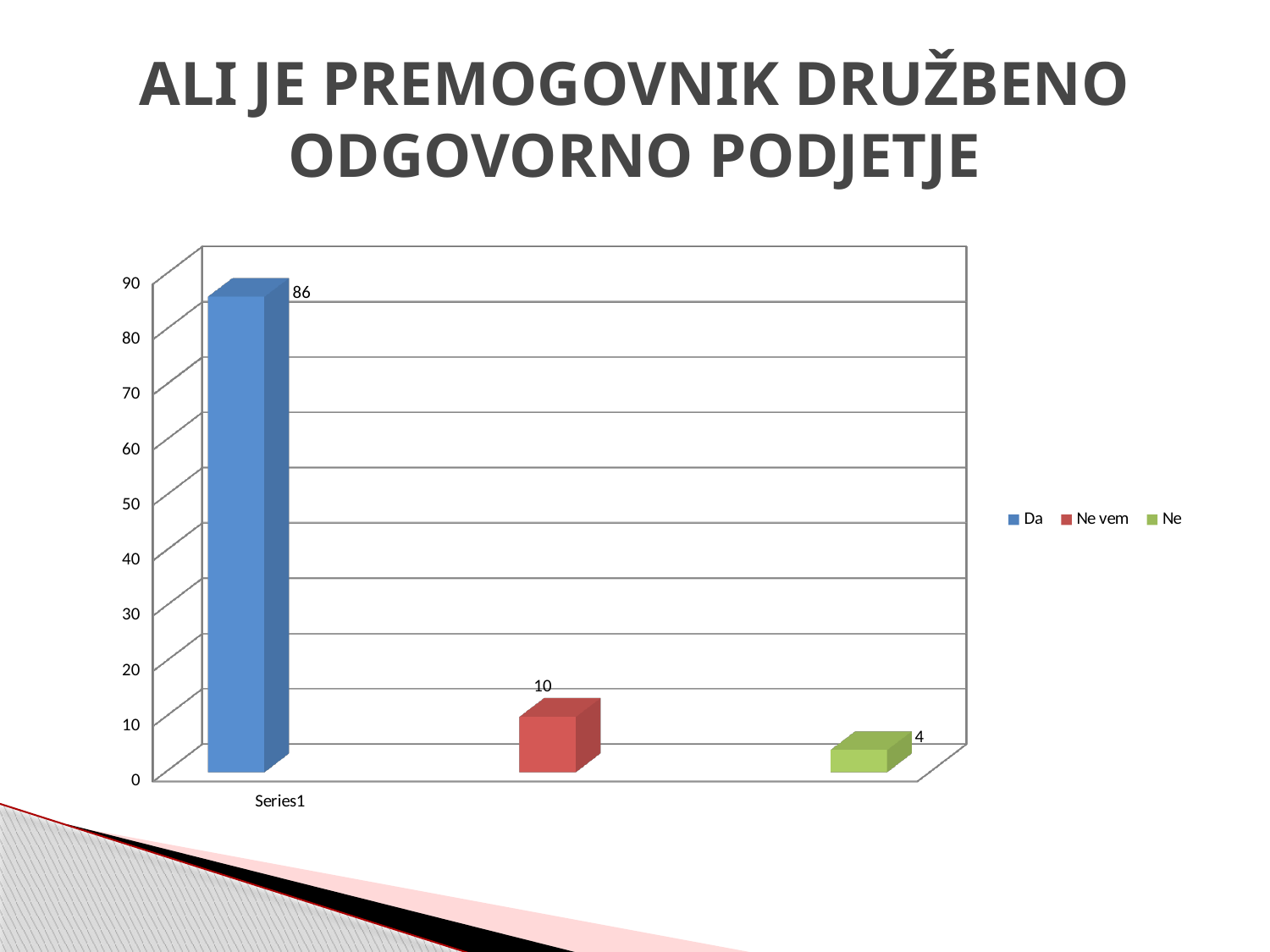
What is the title of the slide? ALI JE PREMOGOVNIK DRUŽBENO ODGOVORNO PODJETJE Is the value for Da greater or less than 80? greater What is the value for Da? 86 Which legend entry has the lowest value? Ne What is the value for Ne? 4 What is the difference between the values for Ne vem and Ne? 6 How many series does the legend list? 3 Which is larger, the value for Ne vem or the value for Ne? Ne vem Which legend entry has the highest value? Da What is the value for Ne vem? 10 What kind of chart is shown on the slide? bar chart What is the difference between the values for Da and Ne vem? 76